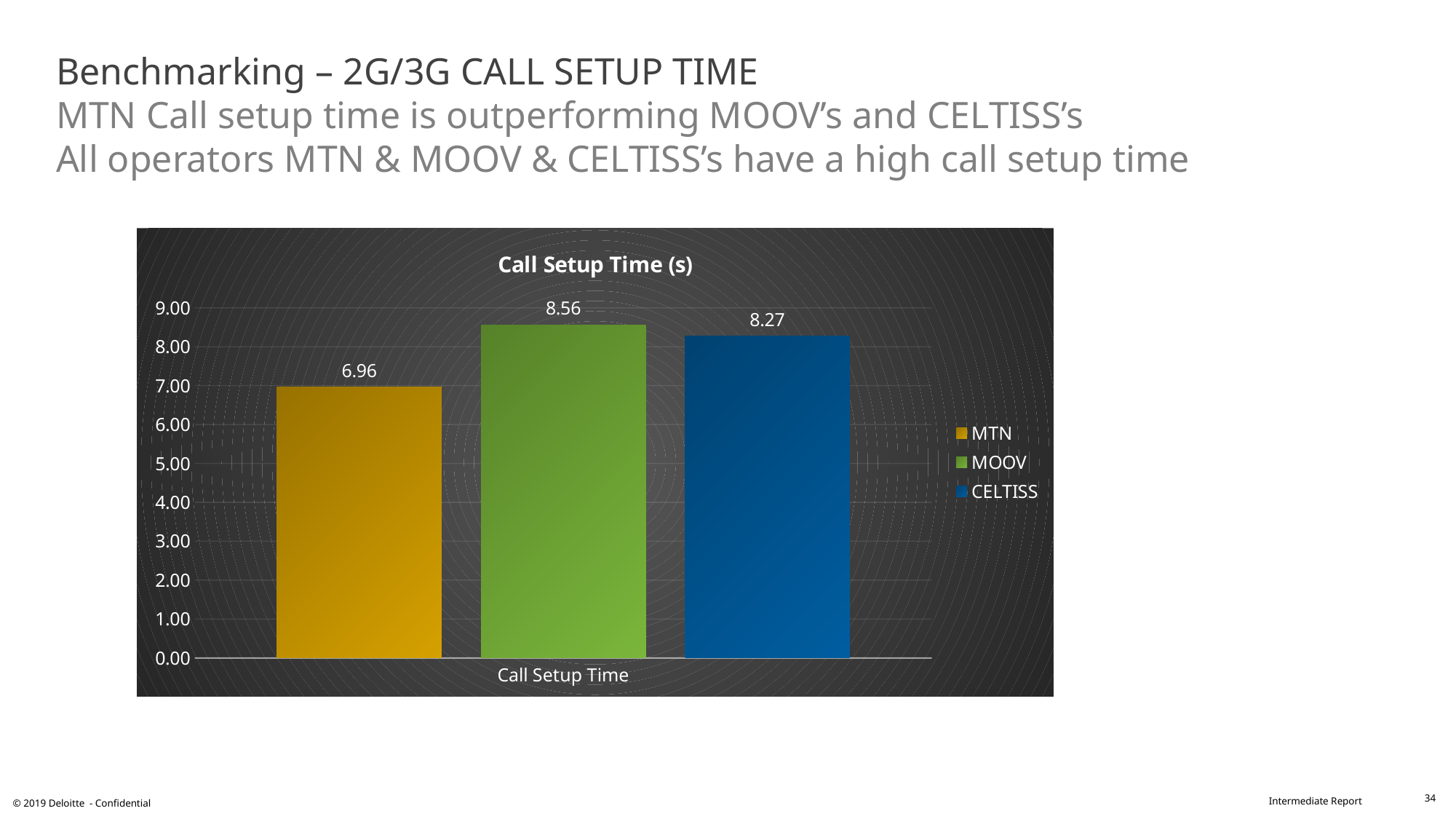
What is the difference between MOOV's and CELTISS's call setup time? 0.29 Which operator has the lowest call setup time? MTN Which has a larger call setup time, CELTISS or MTN? CELTISS What is the call setup time for CELTISS? 8.27 What kind of chart is shown on the slide? bar chart Which operator has the highest call setup time? MOOV What is the title of the chart? Call Setup Time (s) What is the call setup time for MOOV? 8.56 What is the difference between MOOV's and MTN's call setup time? 1.60 Is the call setup time for MTN greater or less than 7.00? less What is the call setup time for MTN? 6.96 How many series does the legend list? 3